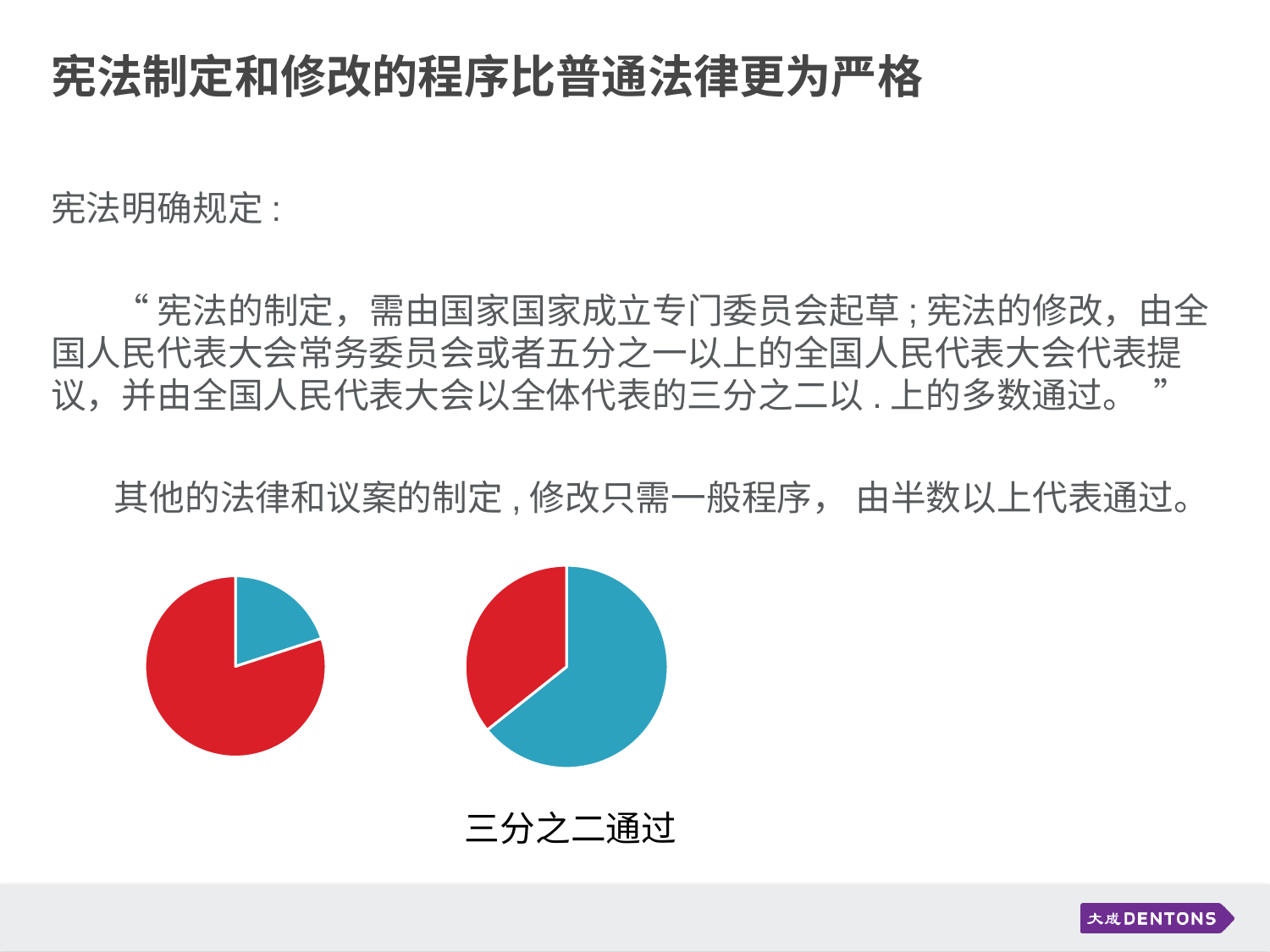
What two colours are used for the slices in the pie charts? red and blue In the right pie chart, which slice is larger, the red one or the blue one? blue According to the caption under the right pie chart, what share does the chart represent as passing? 三分之二 What kind of chart is the chart on the left of the slide? pie chart In the right pie chart, which colour is the largest slice? blue What is the caption printed under the right pie chart? 三分之二通过 What kind of chart is the chart on the right of the slide? pie chart In the left pie chart, how many slices are there? 2 In the left pie chart, which colour is the smallest slice? blue In the right pie chart, how many slices are there? 2 How many pie charts are shown on the slide? 2 In the left pie chart, which slice is larger, the red one or the blue one? red